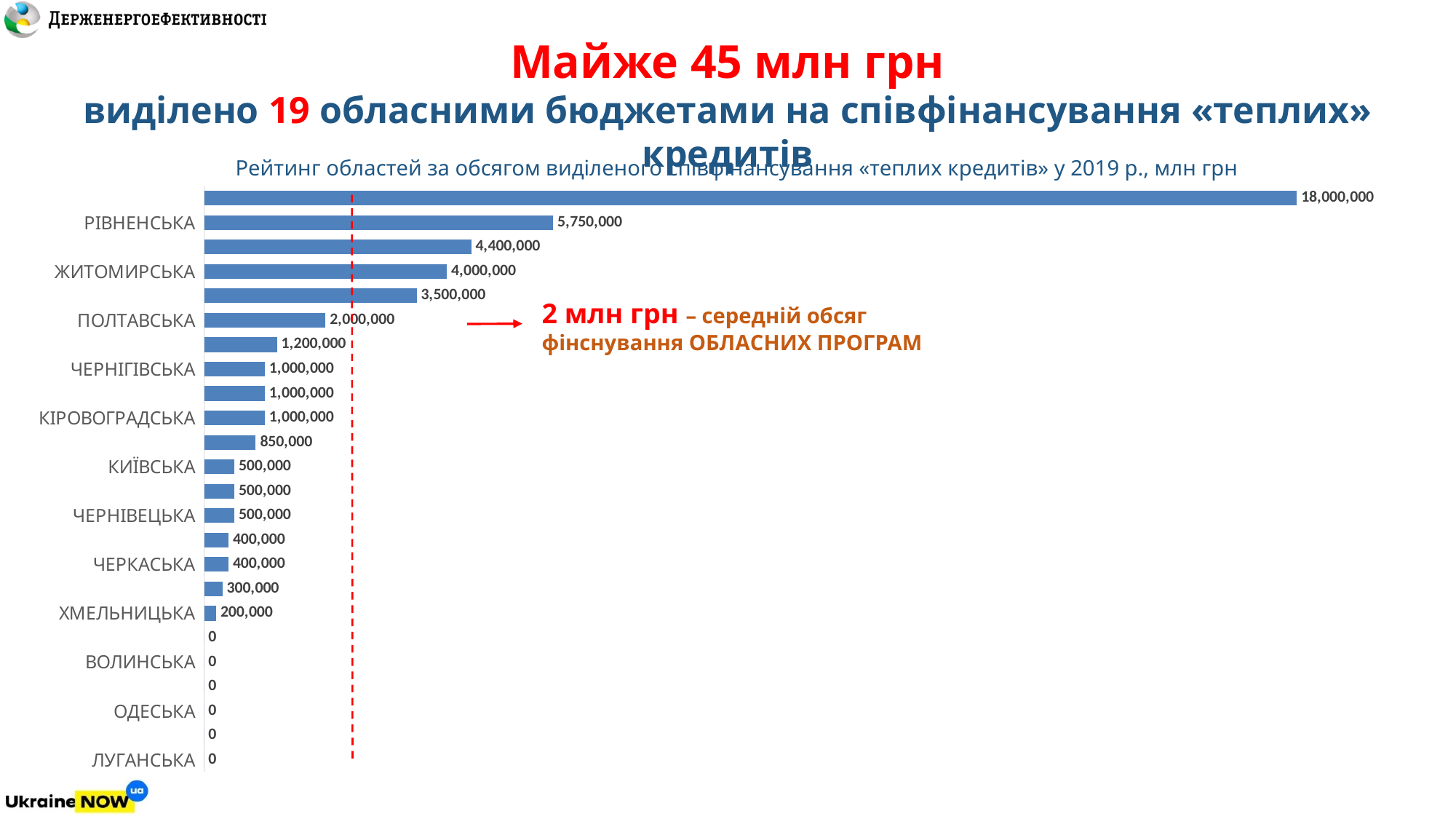
What value does the red dashed vertical line on the chart mark? 2 млн грн (середній обсяг фінансування обласних програм) Which has a larger value, ЧЕРНІГІВСЬКА or КИЇВСЬКА? ЧЕРНІГІВСЬКА What value is shown for ВОЛИНСЬКА? 0 What value is shown for ЖИТОМИРСЬКА? 4,000,000 What is the difference between the values for РІВНЕНСЬКА and ЖИТОМИРСЬКА? 1,750,000 What value is shown for ХМЕЛЬНИЦЬКА? 200,000 What is the highest value shown on the chart? 18,000,000 What kind of chart is shown on the slide? Bar chart What is the difference between the values for ПОЛТАВСЬКА and ЧЕРКАСЬКА? 1,600,000 What value is shown for РІВНЕНСЬКА? 5,750,000 What value is shown for ПОЛТАВСЬКА? 2,000,000 How many bars (categories) are plotted on the chart? 24